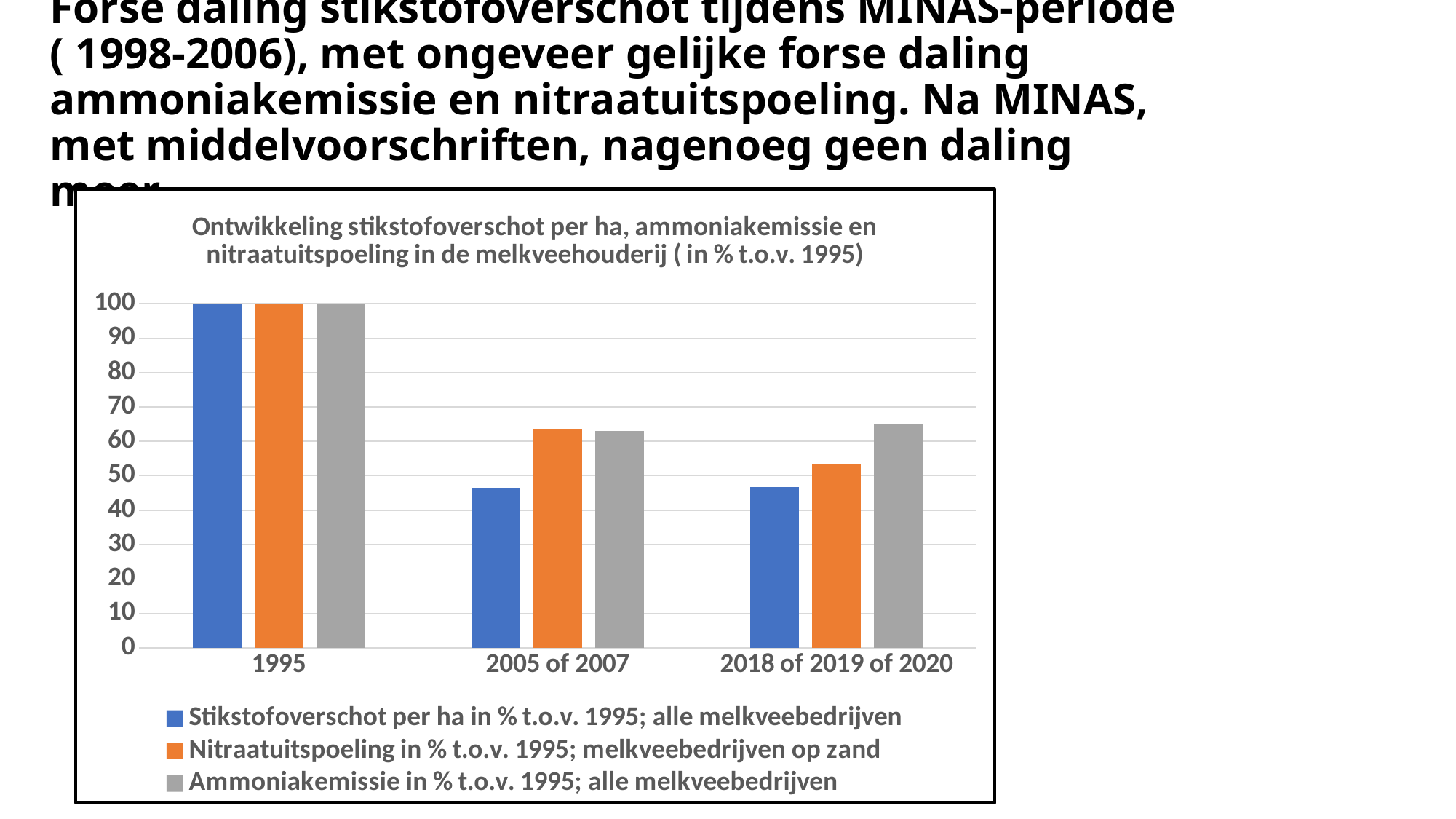
How many series does the chart's legend list? 3 How many categories are shown on the x axis of the chart? 3 Is the value for 'Ammoniakemissie in % t.o.v. 1995; alle melkveebedrijven' in '2018 of 2019 of 2020' greater or less than 60? greater In the category '2005 of 2007', which series has the lowest value? Stikstofoverschot per ha in % t.o.v. 1995; alle melkveebedrijven What kind of chart is shown on the slide? bar chart In the category '2018 of 2019 of 2020', which series has the highest value? Ammoniakemissie in % t.o.v. 1995; alle melkveebedrijven Is the value for 'Nitraatuitspoeling in % t.o.v. 1995; melkveebedrijven op zand' in '2005 of 2007' greater or less than 60? greater What is the value of 'Stikstofoverschot per ha in % t.o.v. 1995; alle melkveebedrijven' for 1995? 100 Is the value for 'Stikstofoverschot per ha in % t.o.v. 1995; alle melkveebedrijven' in '2005 of 2007' greater or less than 50? less What is the value of 'Ammoniakemissie in % t.o.v. 1995; alle melkveebedrijven' for 1995? 100 Which colour represents 'Nitraatuitspoeling in % t.o.v. 1995; melkveebedrijven op zand' in the chart? orange In '2018 of 2019 of 2020', which is larger: the value for 'Nitraatuitspoeling in % t.o.v. 1995; melkveebedrijven op zand' or for 'Stikstofoverschot per ha in % t.o.v. 1995; alle melkveebedrijven'? Nitraatuitspoeling in % t.o.v. 1995; melkveebedrijven op zand